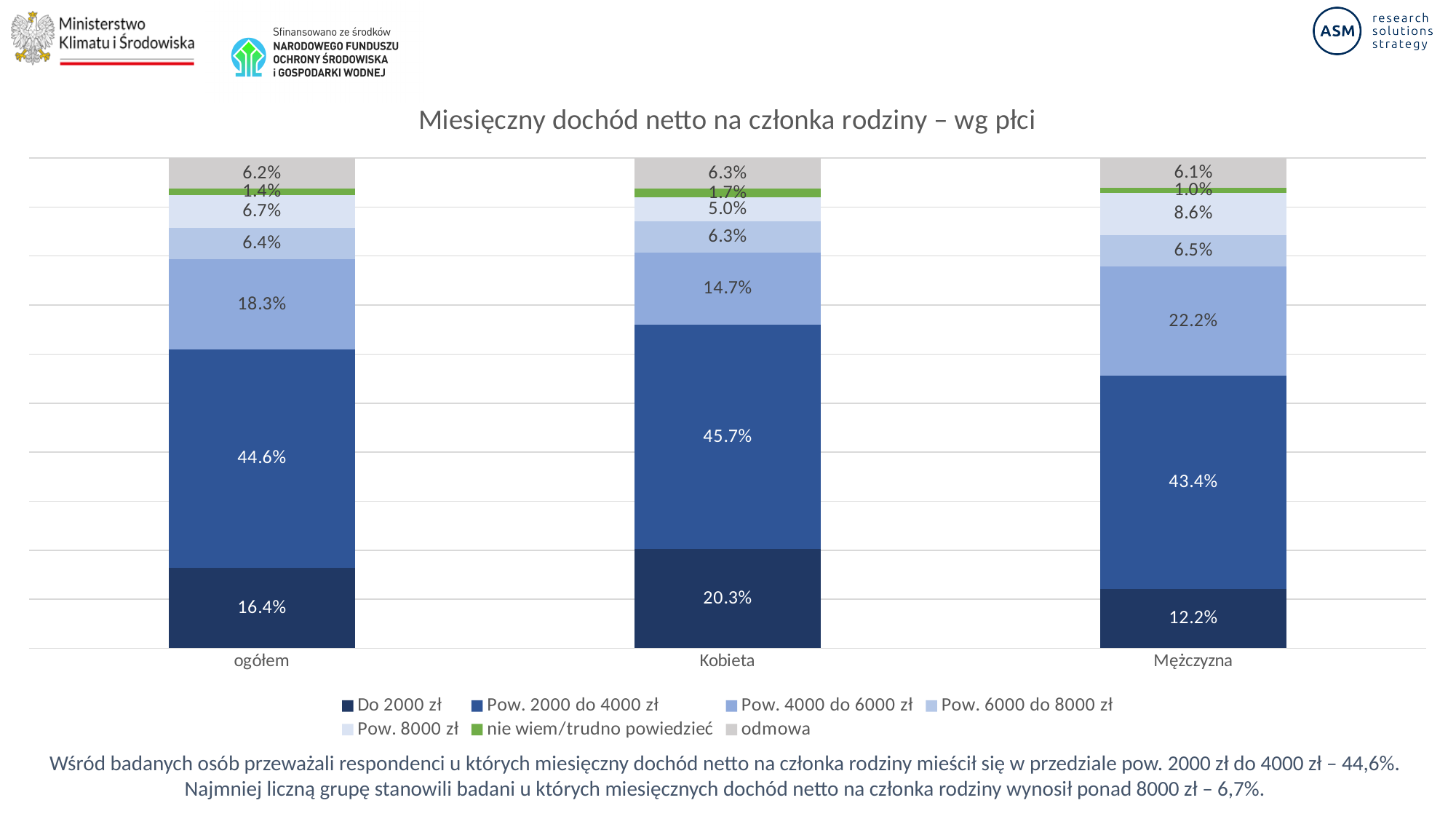
What is the value for 'Pow. 2000 do 4000 zł' in the 'ogółem' bar? 44.6% Which is larger: the 'Pow. 4000 do 6000 zł' value for 'Mężczyzna' or for 'Kobieta'? Mężczyzna What is the difference between the 'Do 2000 zł' values for 'Kobieta' and 'Mężczyzna'? 8.1 percentage points What is the title of the chart? Miesięczny dochód netto na członka rodziny – wg płci What is the value for 'Pow. 8000 zł' in the 'Mężczyzna' bar? 8.6% Which category has the lowest value for 'Do 2000 zł'? Mężczyzna What is the value for 'Do 2000 zł' in the 'Kobieta' bar? 20.3% How many series does the legend list? 7 What is the value for 'odmowa' in the 'Kobieta' bar? 6.3% How many categories are shown on the x axis? 3 Which category has the highest value for 'Pow. 2000 do 4000 zł'? Kobieta What kind of chart is shown on the slide? Stacked bar chart